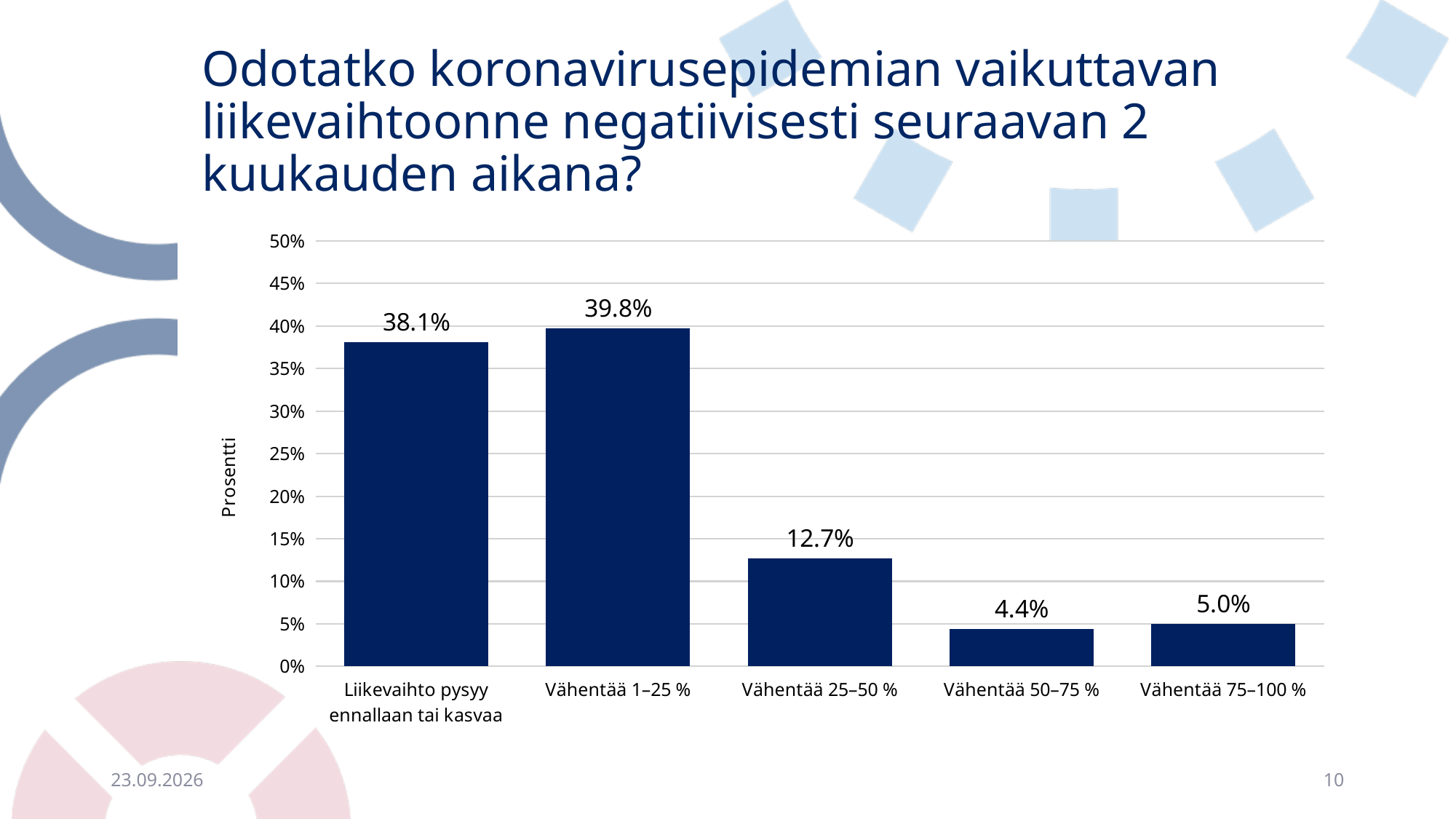
What is the value for "Liikevaihto pysyy ennallaan tai kasvaa"? 38.1% What is the difference between the values for "Vähentää 25–50 %" and "Vähentää 75–100 %"? 7.7% Which category has the lowest value? Vähentää 50–75 % How many categories are shown on the x axis? 5 Which is larger, the value for "Vähentää 25–50 %" or the value for "Vähentää 50–75 %"? Vähentää 25–50 % Which category has the highest value? Vähentää 1–25 % What kind of chart is shown on the slide? Bar chart What is the value for "Vähentää 75–100 %"? 5.0% What is the value for "Vähentää 25–50 %"? 12.7% What is the value for "Vähentää 50–75 %"? 4.4% What is the value for "Vähentää 1–25 %"? 39.8% What is the difference between the values for "Vähentää 1–25 %" and "Liikevaihto pysyy ennallaan tai kasvaa"? 1.7%